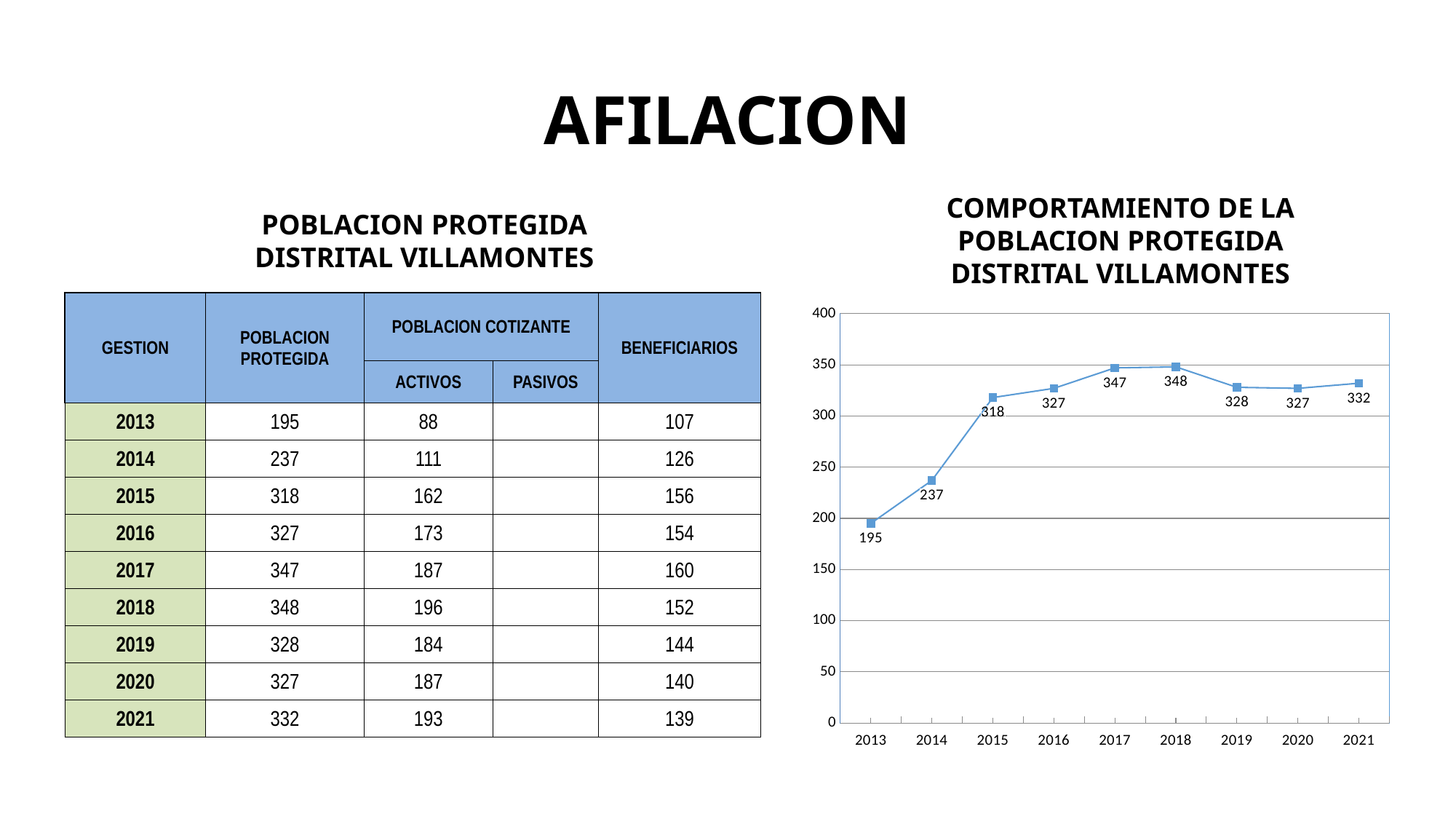
What is the value plotted for 2018 in the line chart? 348 What is the value plotted for 2021 in the line chart? 332 Which year has the lowest value in the line chart? 2013 Which year has the highest value in the line chart? 2018 How many years are plotted on the x axis of the line chart? 9 Is the value for 2014 in the line chart greater or less than 250? less What is the value plotted for 2013 in the line chart? 195 What is the difference between the values for 2015 and 2014 in the line chart? 81 What is the title of the line chart? COMPORTAMIENTO DE LA POBLACION PROTEGIDA DISTRITAL VILLAMONTES Does the plotted value rise or fall from 2013 to 2018 in the line chart? rise What kind of chart is shown on the right side of the slide? line chart In the line chart, is the value for 2019 larger or smaller than the value for 2018? smaller